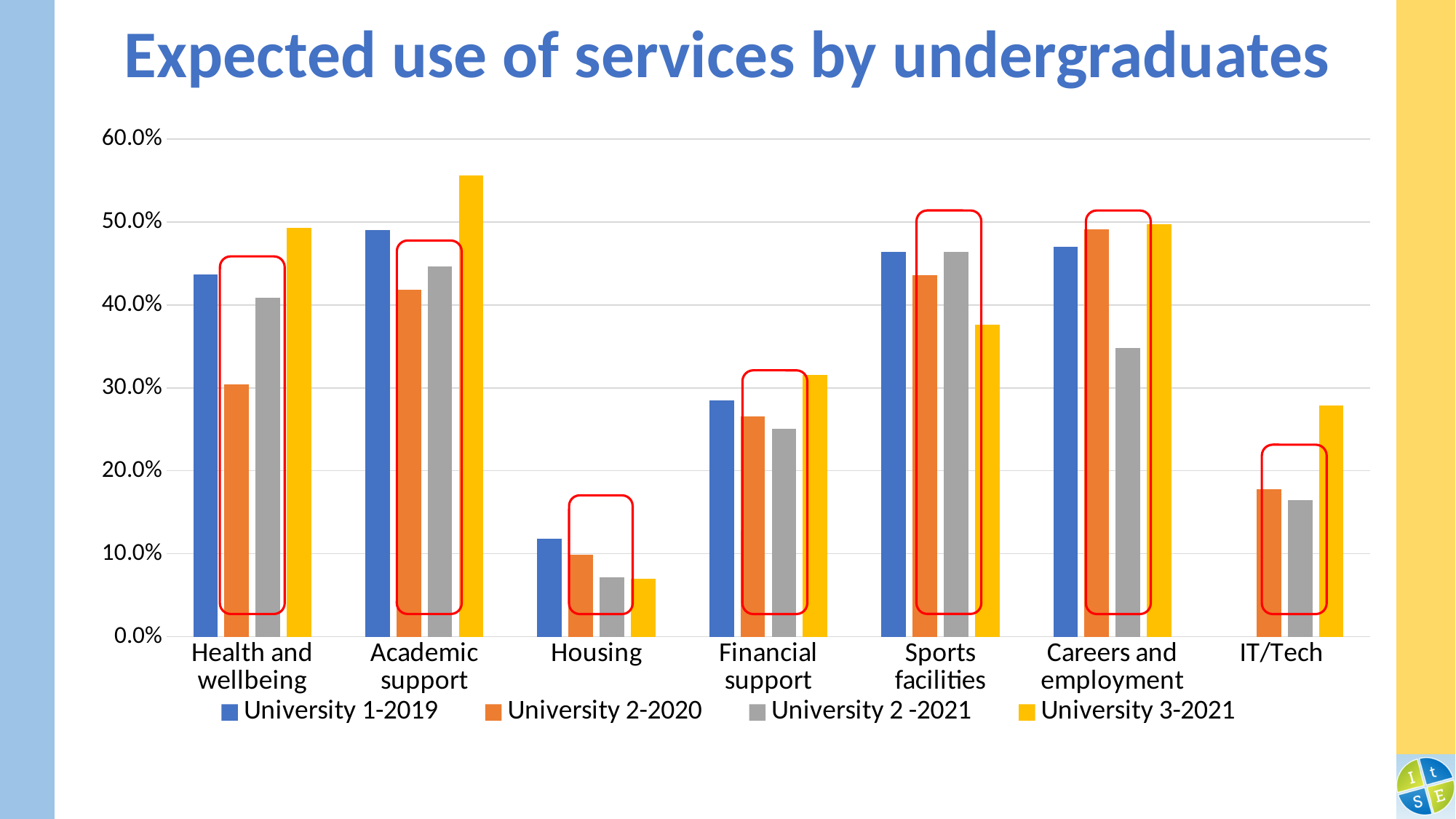
For Housing, which is larger: the University 1-2019 value or the University 3-2021 value? University 1-2019 How many series does the legend list? 4 What is the title of the chart? Expected use of services by undergraduates For which service category is the University 3-2021 value lowest? Housing For Careers and employment, which is larger: the University 2 -2021 value or the University 3-2021 value? University 3-2021 For which service category is the University 1-2019 value highest? Academic support What kind of chart is shown on the slide? Bar chart How many service categories are shown on the x axis? 7 Is the University 3-2021 value for Academic support greater or less than 50.0%? greater Is the University 2-2020 value for Health and wellbeing greater or less than 40.0%? less Is the University 3-2021 value for IT/Tech greater or less than 20.0%? greater For which service category is the University 3-2021 value highest? Academic support